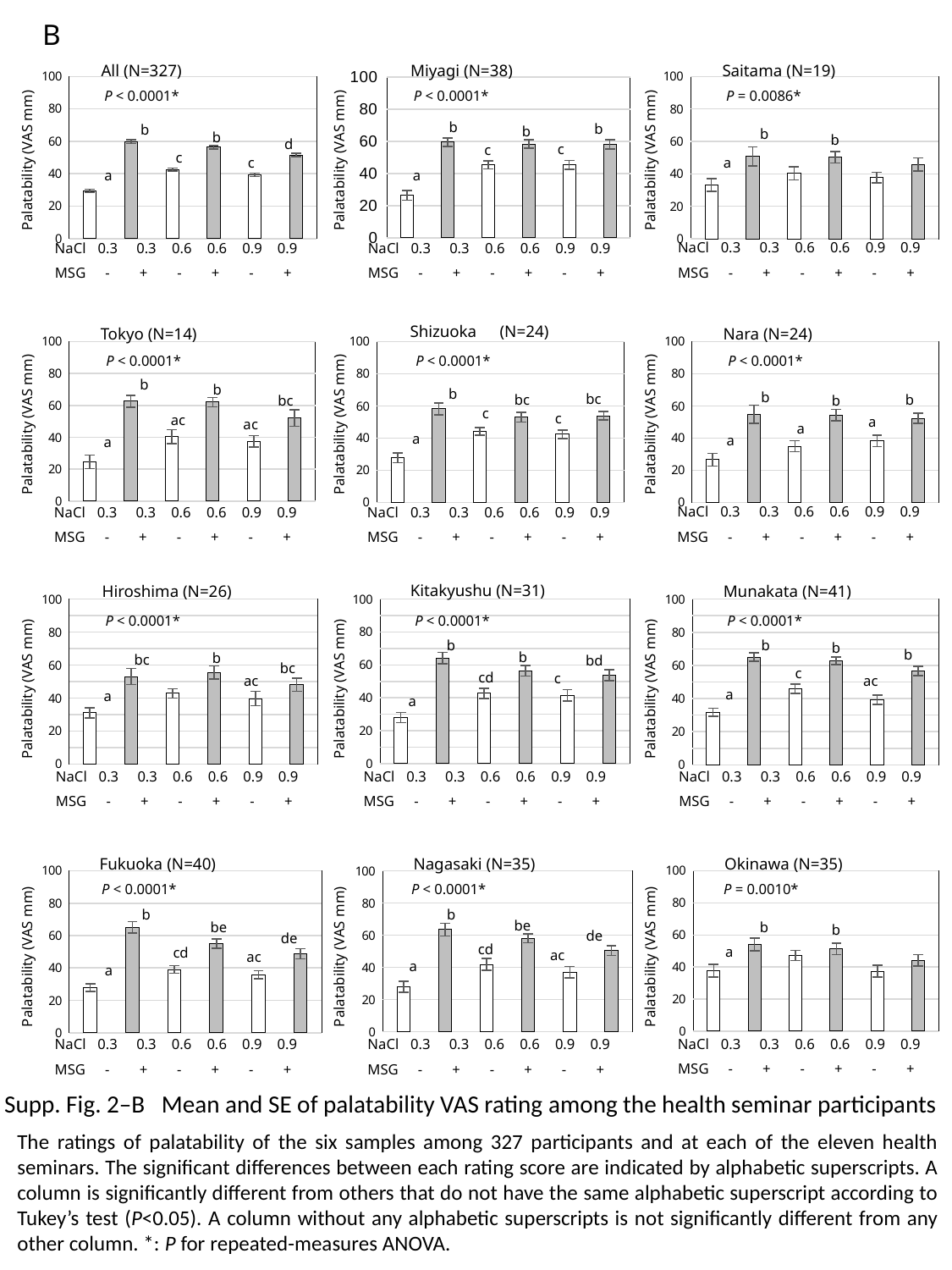
In the Fukuoka (N=40) chart, which bar is the highest? NaCl 0.3 with MSG In the Kitakyushu (N=31) chart, which is larger: NaCl 0.3 with MSG or NaCl 0.9 with MSG? NaCl 0.3 with MSG In the All (N=327) chart, is the value for NaCl 0.3 with MSG greater or less than 40? greater In the Saitama (N=19) chart, which is larger: NaCl 0.3 with MSG or NaCl 0.3 without MSG? NaCl 0.3 with MSG What kind of chart is the All (N=327) chart? bar chart How many bars are plotted in the Tokyo (N=14) chart? 6 What P value is printed on the Saitama (N=19) chart? P = 0.0086* In the All (N=327) chart, is the value for NaCl 0.3 without MSG greater or less than 40? less In the Miyagi (N=38) chart, which bar is the lowest? NaCl 0.3 without MSG In the Munakata (N=41) chart, is the value for NaCl 0.9 with MSG greater or less than 40? greater How many charts are shown on the slide? 12 What P value is printed on the Okinawa (N=35) chart? P = 0.0010*